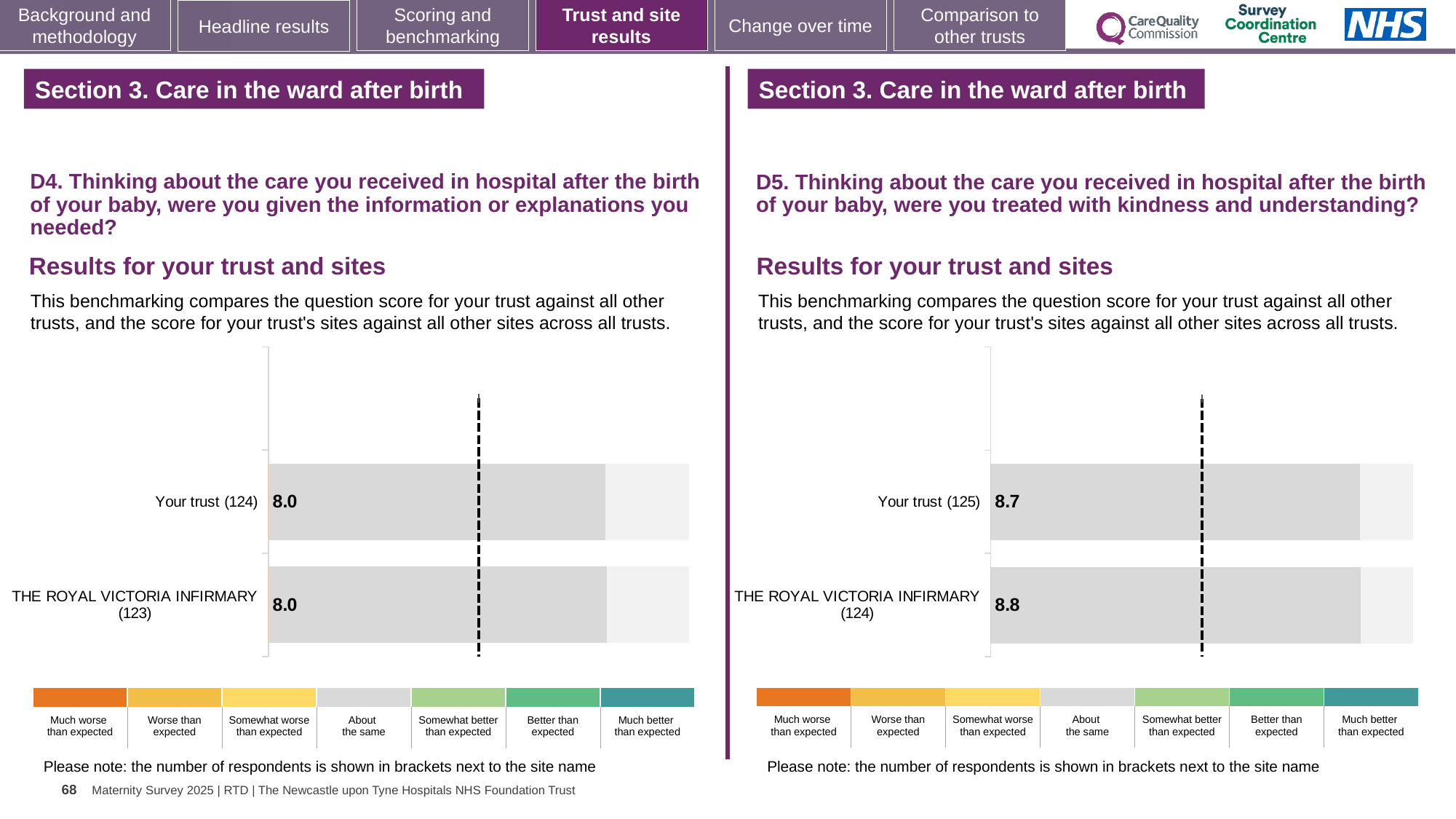
In the D5 chart on the right, what is the score for The Royal Victoria Infirmary? 8.8 In the D5 chart on the right, what is the difference between the score for The Royal Victoria Infirmary and the score for Your trust? 0.1 What type of chart is used for the D5 results on the right? Bar chart In the D4 chart on the left, how many respondents are shown in brackets for Your trust? 124 How many bars are plotted in the D4 chart on the left? 2 How many categories does the colour key below the D4 chart on the left list, from 'Much worse than expected' to 'Much better than expected'? 7 In the D4 chart on the left, what is the score for Your trust? 8.0 In the D4 chart on the left, what is the score for The Royal Victoria Infirmary? 8.0 In the D5 chart on the right, which has the higher score, Your trust or The Royal Victoria Infirmary? The Royal Victoria Infirmary In the D5 chart on the right, which row has the lowest score? Your trust In the D5 chart on the right, how many respondents are shown in brackets for The Royal Victoria Infirmary? 124 In the D5 chart on the right, what is the score for Your trust? 8.7